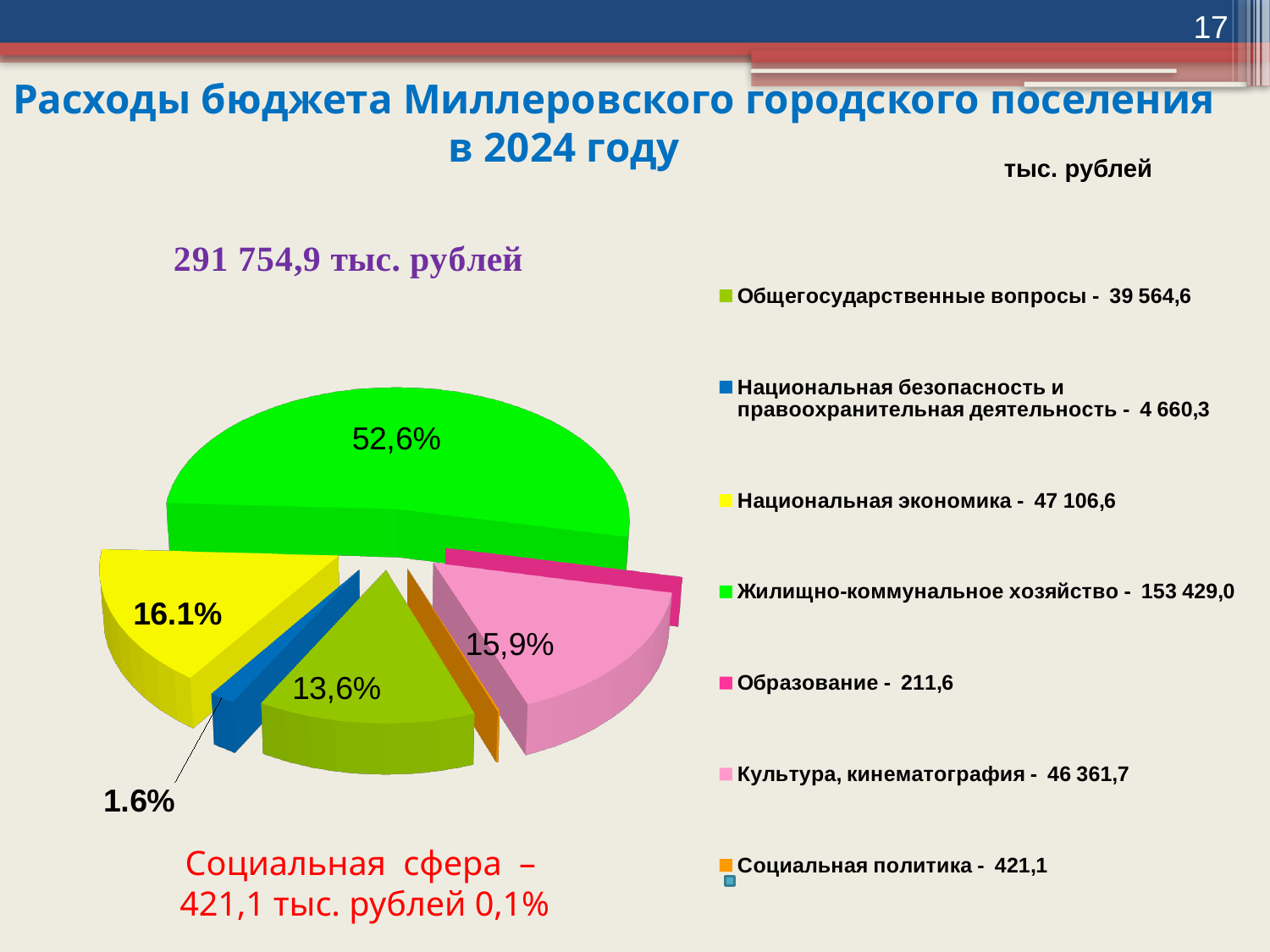
What percentage label is shown on the Жилищно-коммунальное хозяйство slice? 52,6% Which category has the smallest value in the legend? Образование What is the difference between Национальная экономика and Культура, кинематография? 744,9 What kind of chart is shown on the slide? pie chart What is the value for Национальная безопасность и правоохранительная деятельность? 4 660,3 What is the value for Национальная экономика? 47 106,6 How many categories does the legend list? 7 What is the value for Жилищно-коммунальное хозяйство? 153 429,0 What total amount of expenditures is shown above the chart? 291 754,9 тыс. рублей What percentage label is shown on the Культура, кинематография slice? 15,9% Which category has the largest share of the budget expenditures? Жилищно-коммунальное хозяйство Which is larger: Общегосударственные вопросы or Культура, кинематография? Культура, кинематография